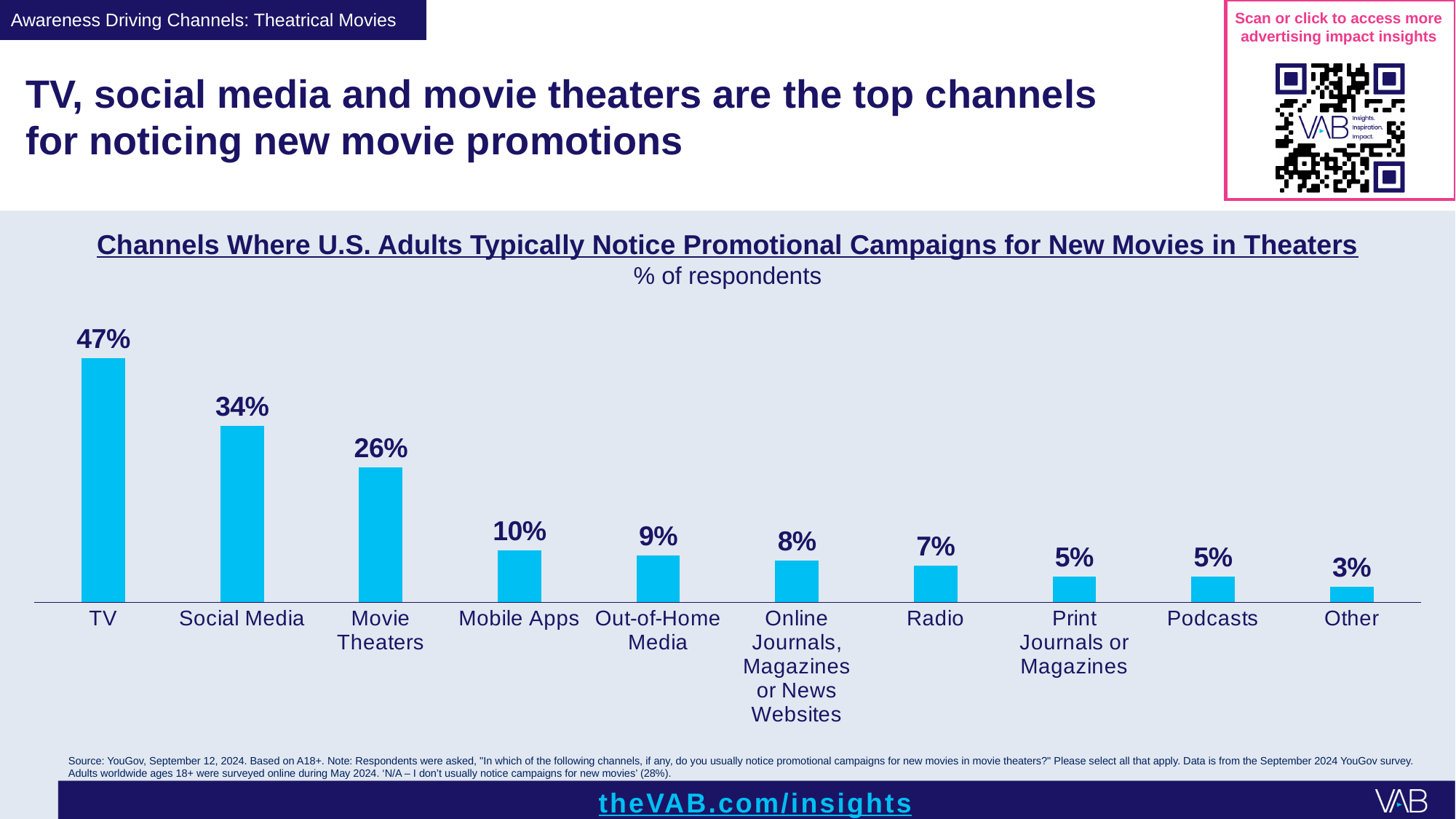
What is the difference in percentage points between TV and Social Media? 13 What is the value shown for Social Media? 34% What type of chart is used on this slide? Bar chart Which channel has the lowest percentage of respondents? Other Which channel has the highest percentage of respondents? TV What is the value for Radio? 7% What is the difference in percentage points between Movie Theaters and Mobile Apps? 16 What percentage of respondents typically notice promotional campaigns for new movies on TV? 47% What percentage of respondents notice movie promotions via Mobile Apps? 10% What is the title of the chart? Channels Where U.S. Adults Typically Notice Promotional Campaigns for New Movies in Theaters Which has a higher value, Out-of-Home Media or Radio? Out-of-Home Media How many channels are shown in the chart? 10